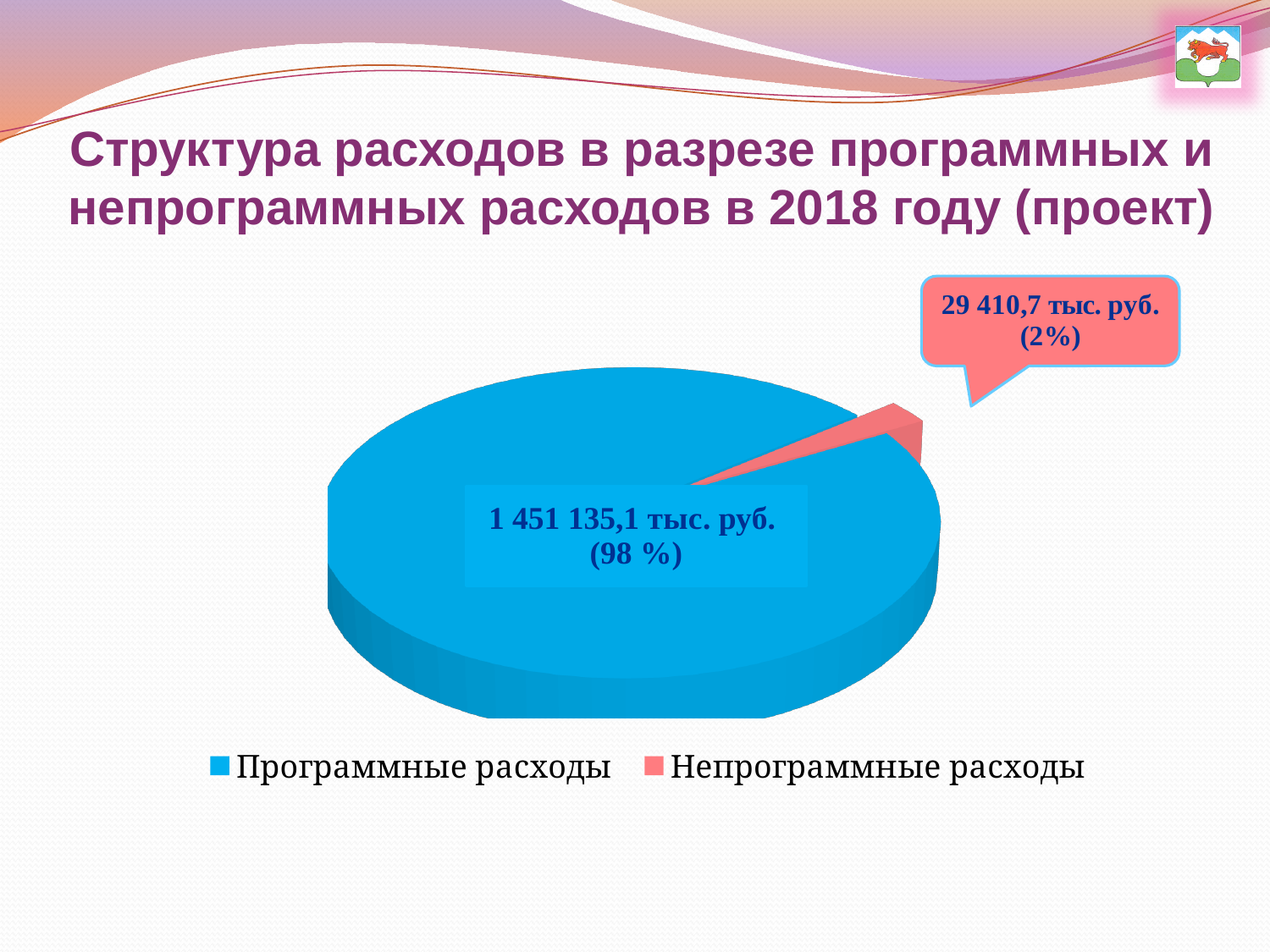
What share of the pie does Непрограммные расходы represent? 2% What type of chart is shown on the slide? Pie chart What colour is the slice for Непрограммные расходы? Red (pink) What is the difference between Программные расходы and Непрограммные расходы? 1 421 724,4 тыс. руб. Which category has the largest slice of the pie? Программные расходы Which category has the smallest slice of the pie? Непрограммные расходы How many categories does the pie chart show? 2 What share of the pie does Программные расходы represent? 98 % How many entries does the legend list? 2 What is the value for Непрограммные расходы? 29 410,7 тыс. руб. What is the value for Программные расходы? 1 451 135,1 тыс. руб. Which is larger, Программные расходы or Непрограммные расходы? Программные расходы